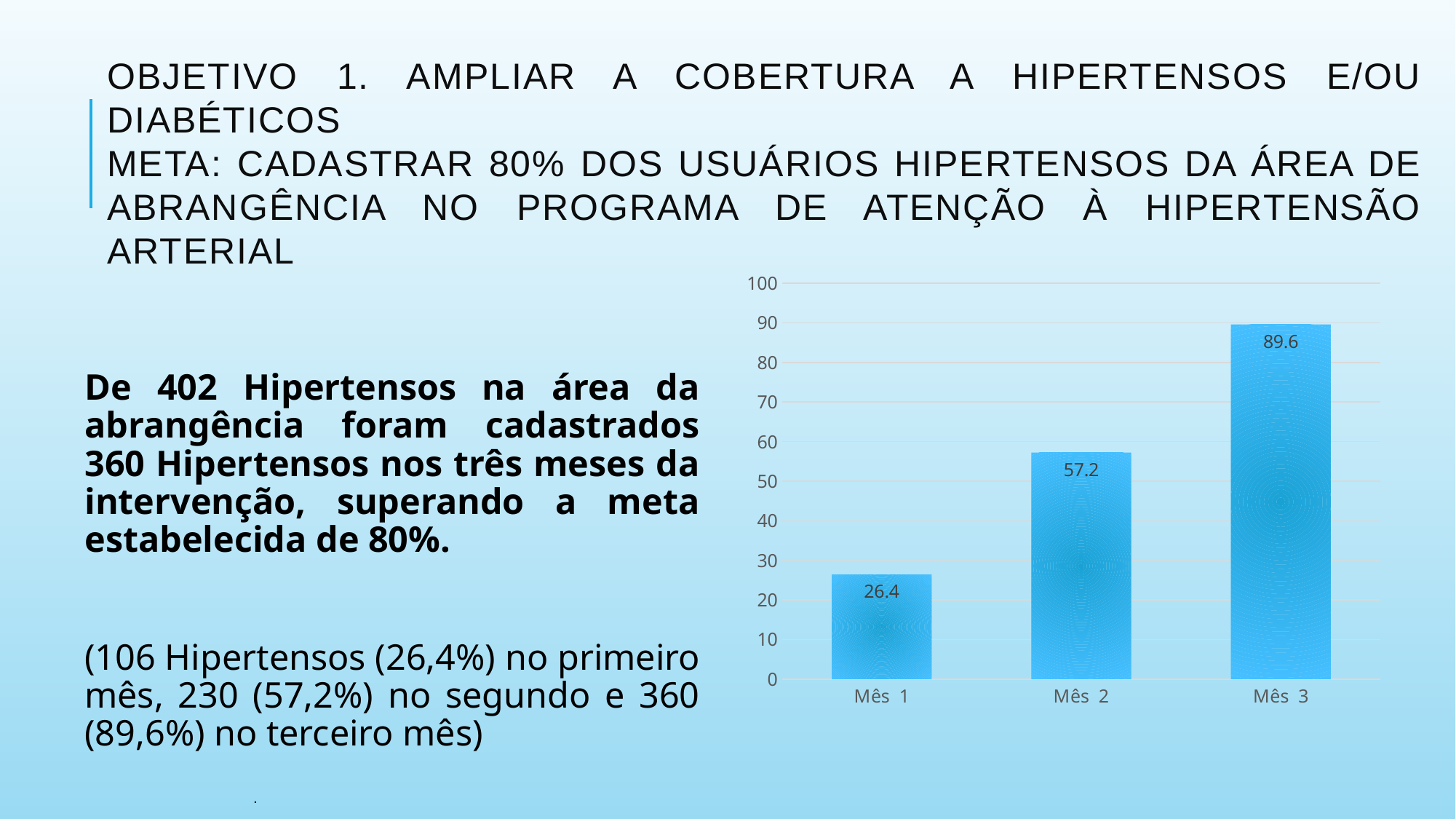
What is the difference between the values for Mês 2 and Mês 1? 30.8 Which month has the highest value? Mês 3 How many categories are shown on the x axis? 3 What kind of chart is shown on the slide? bar chart What is the value for Mês 2? 57.2 Is the value for Mês 2 greater or less than 50? greater Do the values rise or fall from Mês 1 to Mês 3? rise What is the value for Mês 1? 26.4 What is the value for Mês 3? 89.6 Which month has the lowest value? Mês 1 Which is larger, the value for Mês 2 or the value for Mês 3? Mês 3 What is the difference between the values for Mês 3 and Mês 1? 63.2